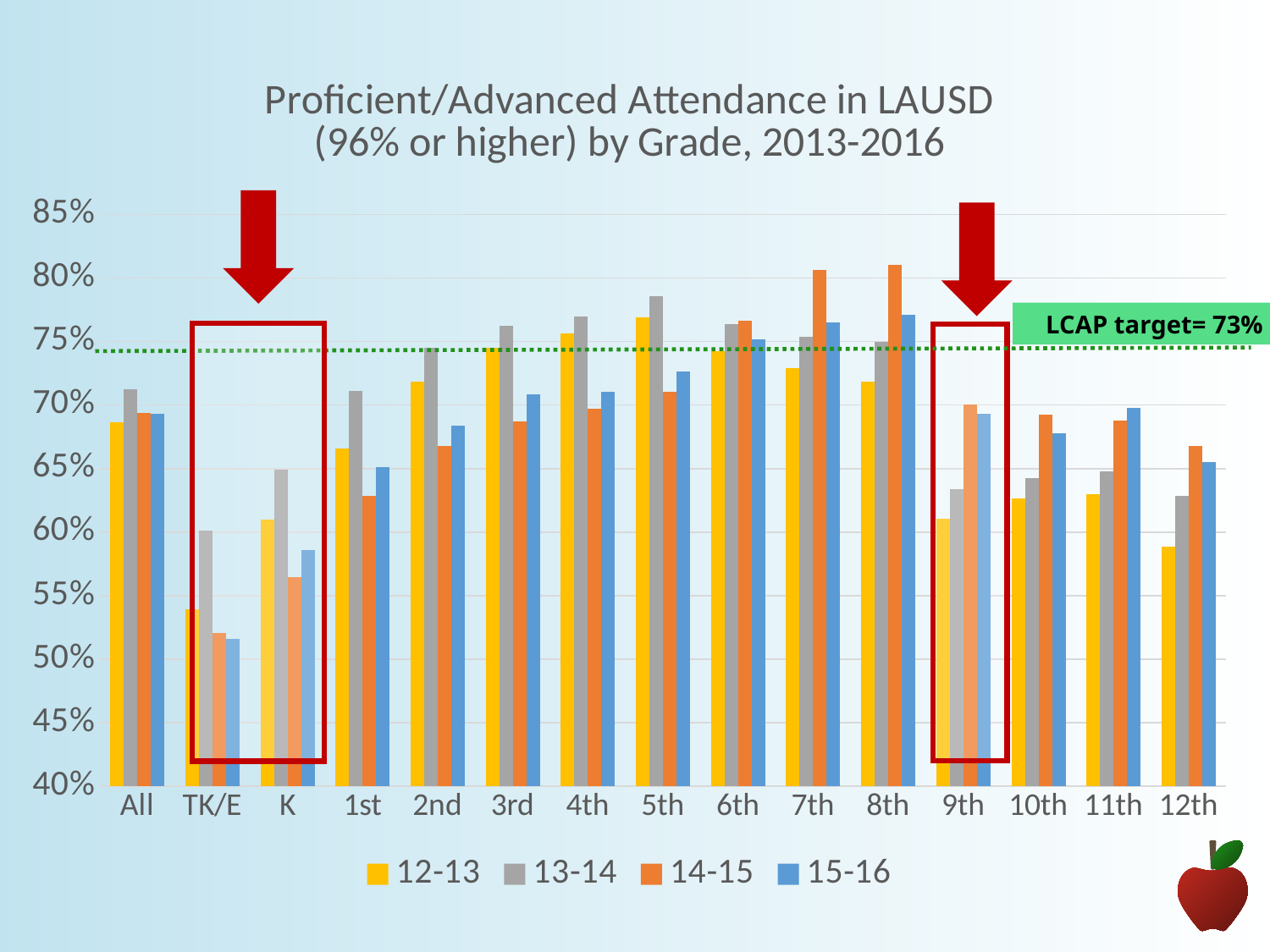
How many grade categories are shown along the x axis? 15 How many series does the legend list? 4 For the 12-13 series, which is larger: TK/E or K? K What kind of chart is shown on the slide? bar chart Do the 14-15 values rise or fall from 5th grade to 8th grade? rise What LCAP target value is labelled on the chart? 73% Is the 14-15 value for 8th grade greater or less than 75%? greater Which grade category has the lowest 12-13 value? TK/E For 9th grade, which is larger: the 12-13 value or the 14-15 value? 14-15 Is the 12-13 value for 12th grade greater or less than 60%? less Which grade category has the highest 12-13 value? 5th Is the 15-16 value for TK/E greater or less than 55%? less